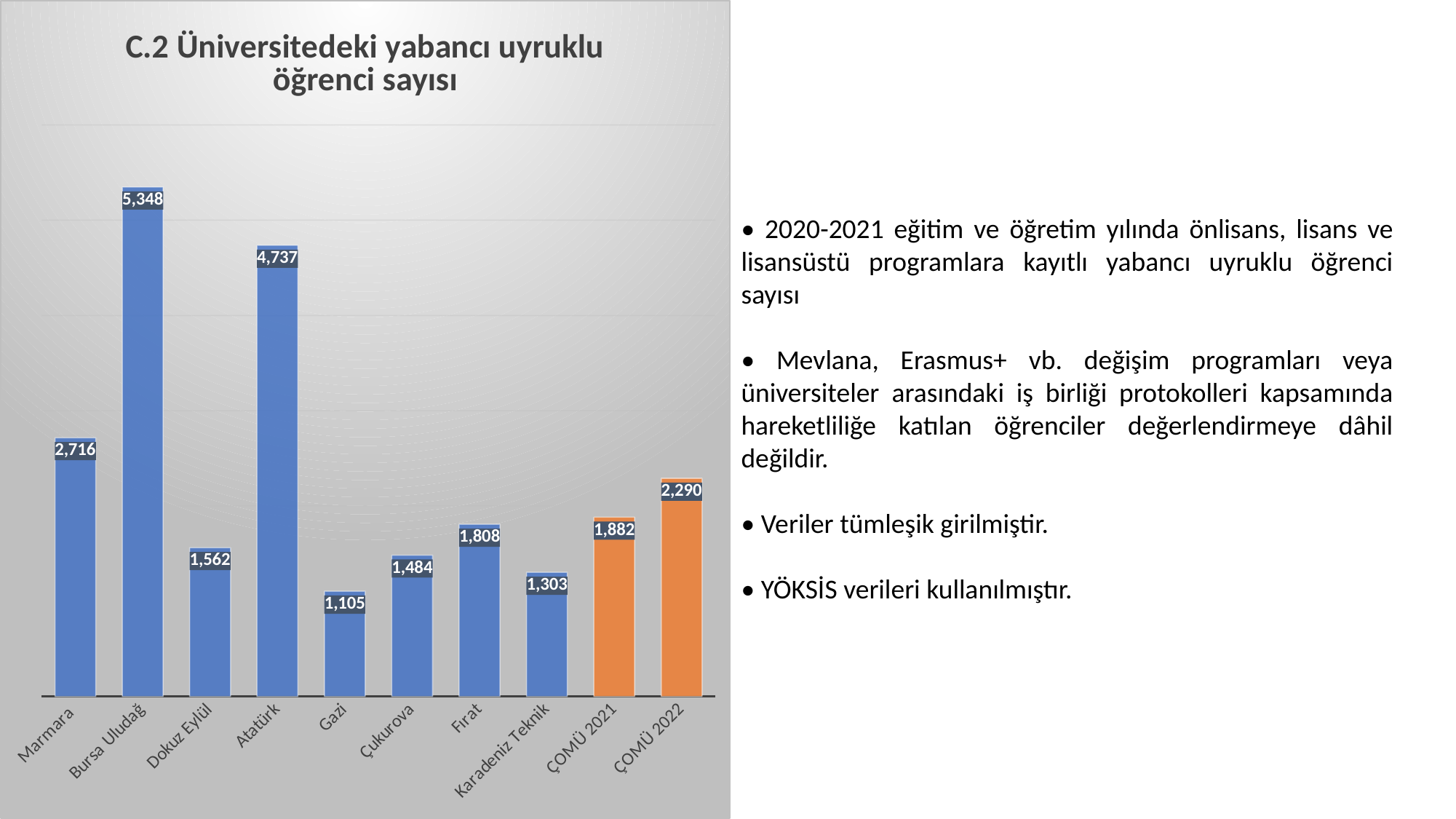
What is the title of the chart? C.2 Üniversitedeki yabancı uyruklu öğrenci sayısı What kind of chart is shown on the slide? Bar chart What is the value for ÇOMÜ 2022? 2,290 What is the value for Gazi? 1,105 Which category has the lowest value? Gazi Which is larger, the value for Fırat or the value for Çukurova? Fırat Which is larger, the value for Marmara or the value for Karadeniz Teknik? Marmara What is the difference between the values for Bursa Uludağ and Atatürk? 611 How many categories are shown on the x axis? 10 Which category has the highest value? Bursa Uludağ What is the difference between the values for ÇOMÜ 2022 and ÇOMÜ 2021? 408 What is the value for Bursa Uludağ? 5,348